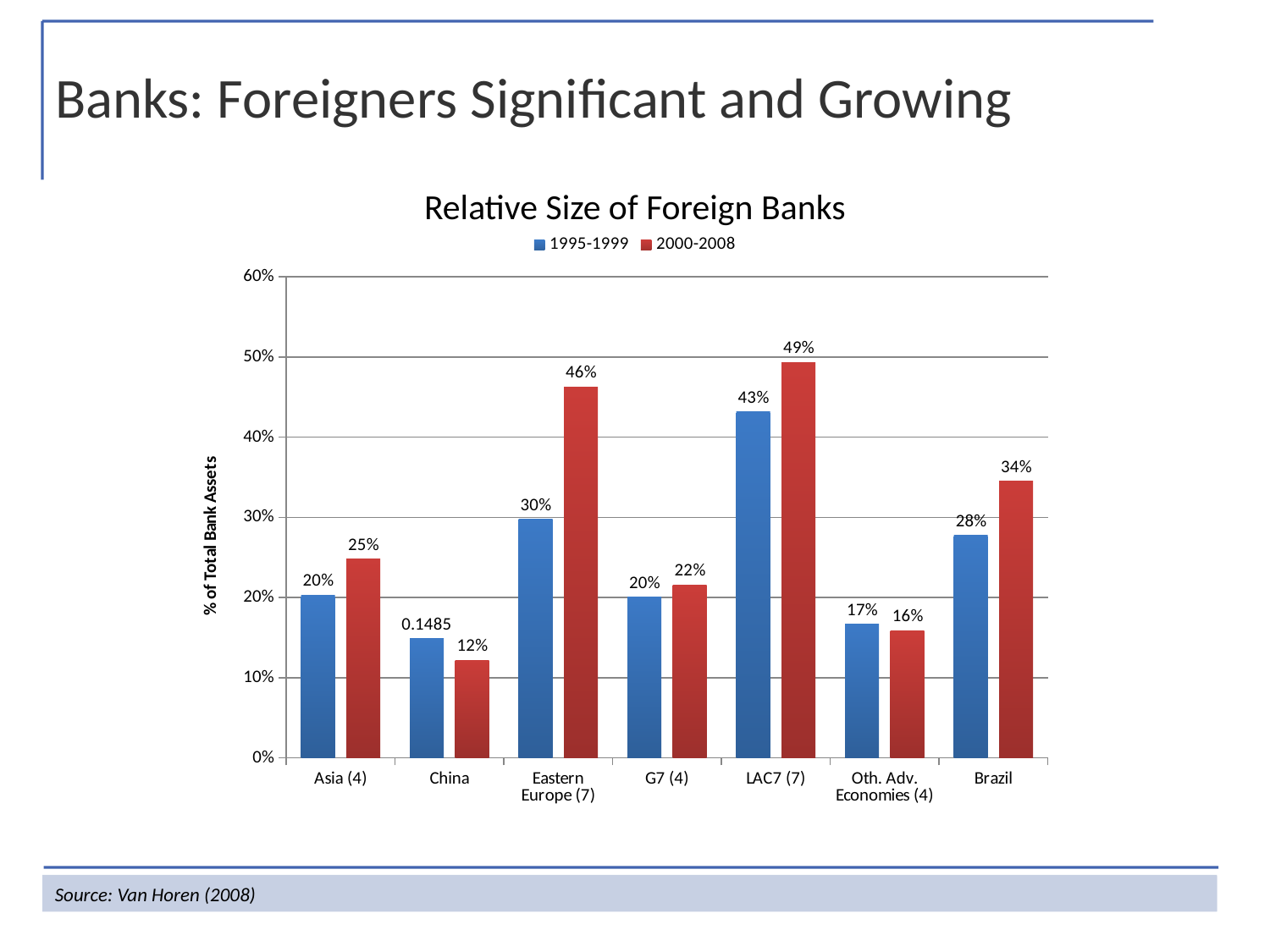
What is the value for LAC7 (7) in the 2000-2008 series? 49% Which is larger for Oth. Adv. Economies (4): the 1995-1999 value or the 2000-2008 value? 1995-1999 What is the value for Brazil in the 2000-2008 series? 34% What kind of chart is shown on the slide? Bar chart What is the value for Eastern Europe (7) in the 1995-1999 series? 30% Which category has the lowest value in the 2000-2008 series? China What is the difference between the 2000-2008 and 1995-1999 values for Eastern Europe (7)? 16% Which category has the highest value in the 2000-2008 series? LAC7 (7) How many series does the legend list? 2 What data label is shown for China in the 1995-1999 series? 0.1485 How many categories are shown on the x axis? 7 Is the 1995-1999 value for LAC7 (7) greater or less than 40%? greater